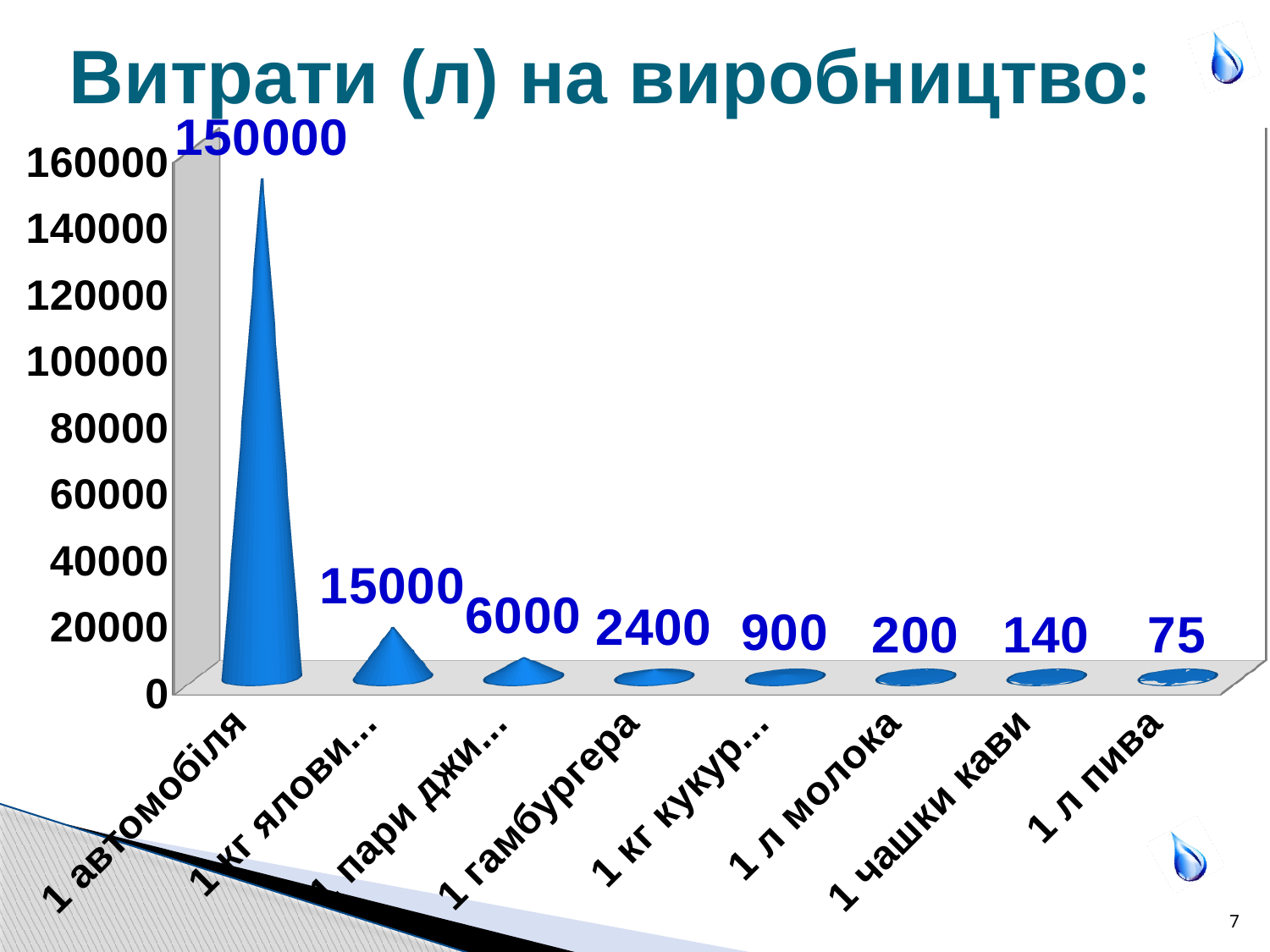
What is the value for 1 л молока? 200 What is the value for 1 автомобіля? 150000 What is the value for 1 гамбургера? 2400 Which is larger, the value for 1 чашки кави or the value for 1 л пива? 1 чашки кави What kind of chart is shown on the slide? bar chart What is the value for 1 л пива? 75 What is the value for 1 чашки кави? 140 Do the values rise or fall from left to right along the x axis? fall Which category has the highest value? 1 автомобіля Which category has the lowest value? 1 л пива What is the difference between the values for 1 л молока and 1 чашки кави? 60 How many categories are shown on the chart? 8